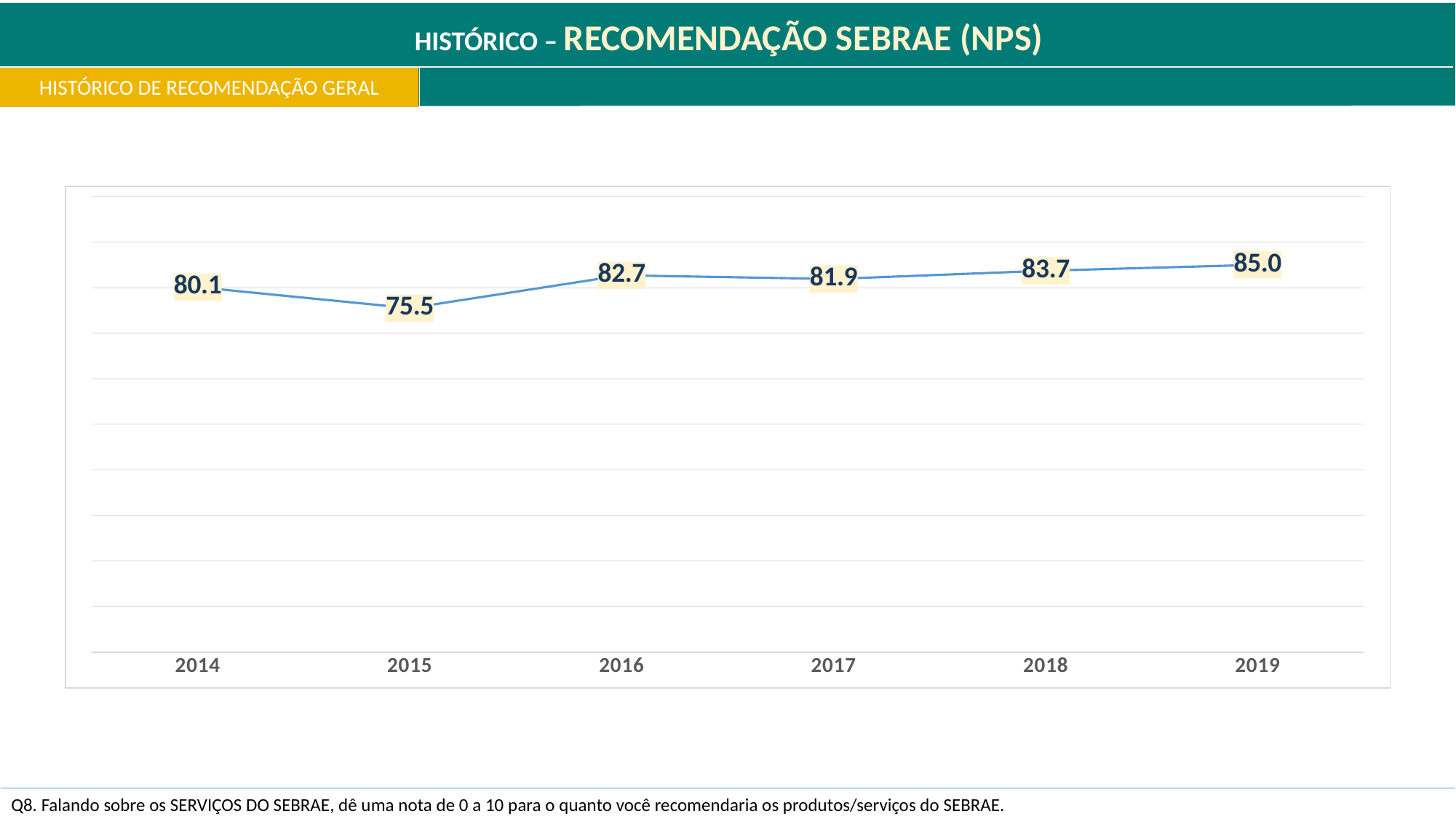
What is the NPS value for 2019? 85.0 What is the NPS value for 2014? 80.1 What is the difference between the NPS values for 2016 and 2015? 7.2 What kind of chart is shown on the slide? Line chart Which year has the highest NPS value? 2019 What is the difference between the NPS values for 2019 and 2014? 4.9 What is the NPS value for 2015? 75.5 How many years are plotted on the chart? 6 Which year has a higher NPS value, 2016 or 2017? 2016 Which year has the lowest NPS value? 2015 Do the NPS values rise or fall from 2015 to 2019? Rise What is the NPS value for 2017? 81.9